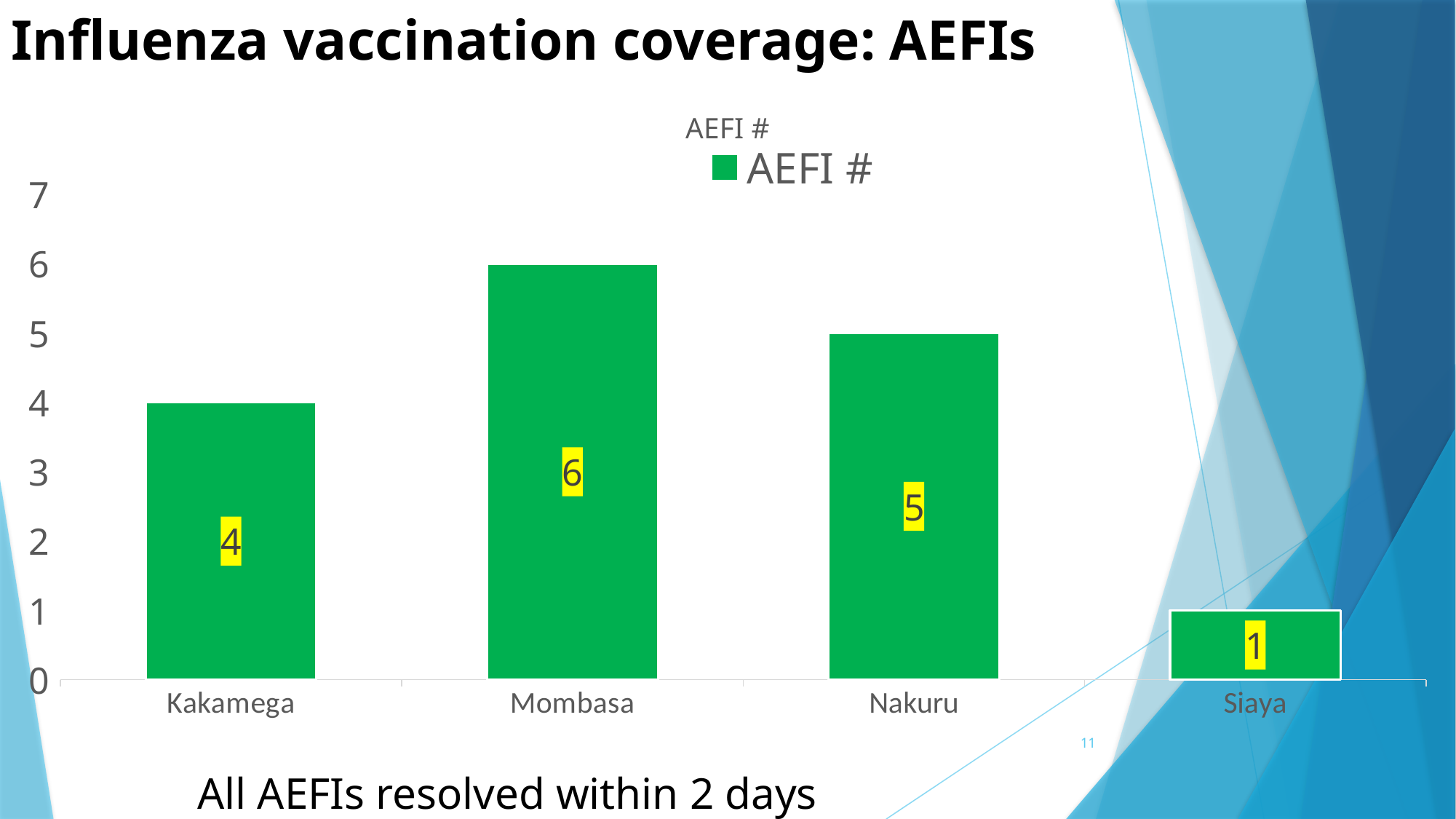
How many series does the chart legend list? 1 What is the AEFI # value for Mombasa? 6 Which county has the highest AEFI #? Mombasa Which has a larger AEFI #, Kakamega or Nakuru? Nakuru What is the AEFI # value for Nakuru? 5 How many counties are shown on the x axis of the chart? 4 What is the AEFI # value for Kakamega? 4 What kind of chart is shown on the slide? Bar chart Which county has the lowest AEFI #? Siaya What is the difference between the AEFI # for Mombasa and Kakamega? 2 What is the difference between the AEFI # for Nakuru and Siaya? 4 What is the AEFI # value for Siaya? 1